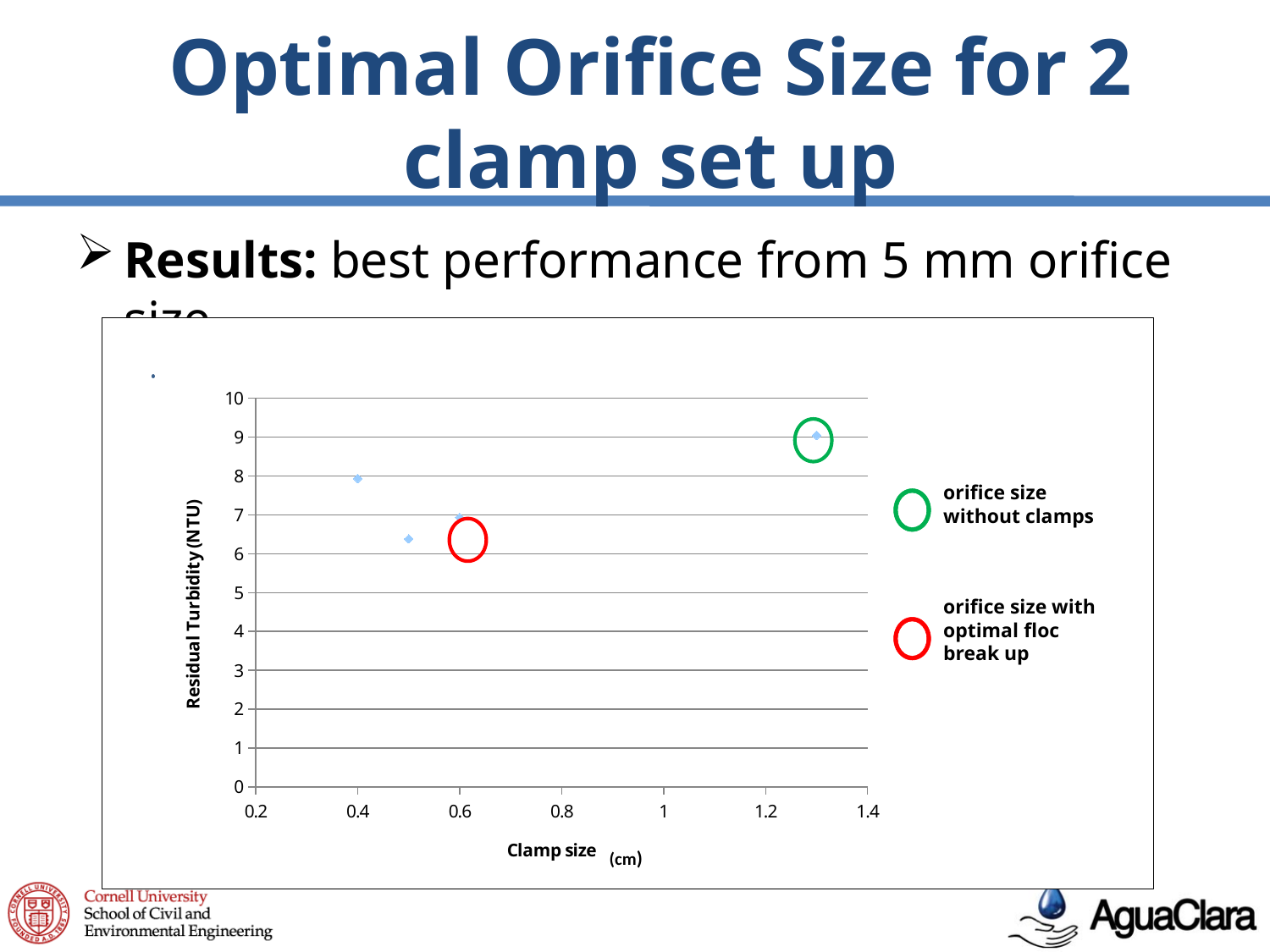
What is the label of the y axis? Residual Turbidity (NTU) Is the residual turbidity at clamp size 0.5 greater or less than 7? less What is the label of the x axis? Clamp size (cm) At which clamp size is the residual turbidity highest? 1.3 What kind of chart is shown on the slide? scatter chart Is the residual turbidity at clamp size 0.4 greater or less than 7? greater Which has the higher residual turbidity, clamp size 0.4 or clamp size 0.5? 0.4 Which has the higher residual turbidity, clamp size 1.3 or clamp size 0.6? 1.3 Is the residual turbidity at clamp size 1.3 greater or less than 8? greater At which clamp size is the residual turbidity lowest? 0.5 How many data points are plotted on the chart? 4